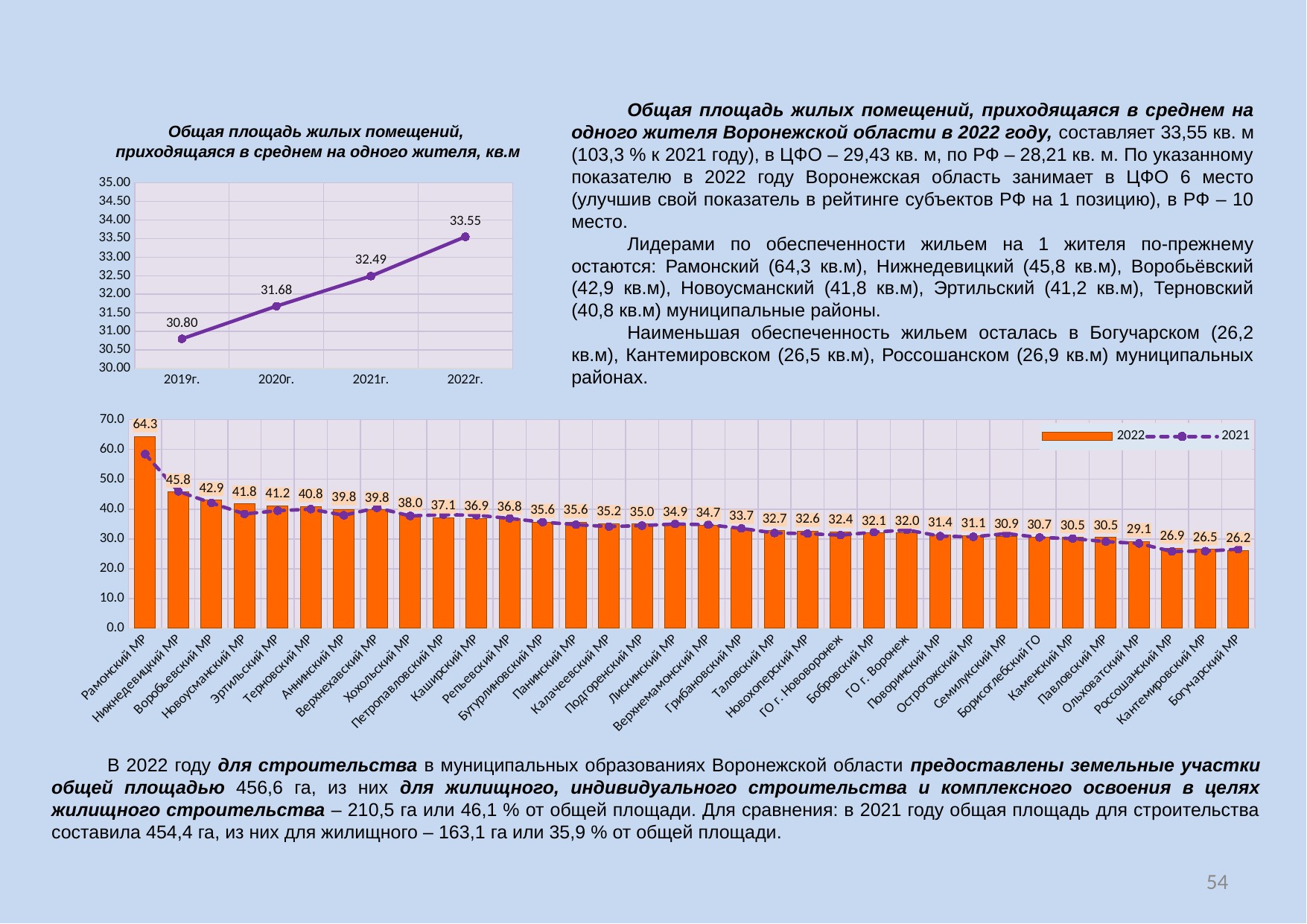
In the bottom chart, what is the difference between the 2022 values for Нижнедевицкий МР and Воробьевский МР? 2.9 In the bottom chart, what is the 2022 value for Рамонский МР? 64.3 In the top-left line chart, do the values rise or fall from 2019г. to 2022г.? rise In the bottom chart, what is the 2022 value for ГО г. Воронеж? 32.0 In the top-left line chart, what is the value for 2022г.? 33.55 In the bottom chart, how many series does the legend list? 2 In the top-left line chart, how many data points are plotted? 4 In the bottom chart, which is larger in 2022: Хохольский МР or Каширский МР? Хохольский МР In the bottom chart, which category has the lowest 2022 bar? Богучарский МР In the top-left line chart, what is the value for 2019г.? 30.80 In the top-left line chart, what is the difference between the 2021г. and 2020г. values? 0.81 In the bottom chart, which category has the highest 2022 bar? Рамонский МР